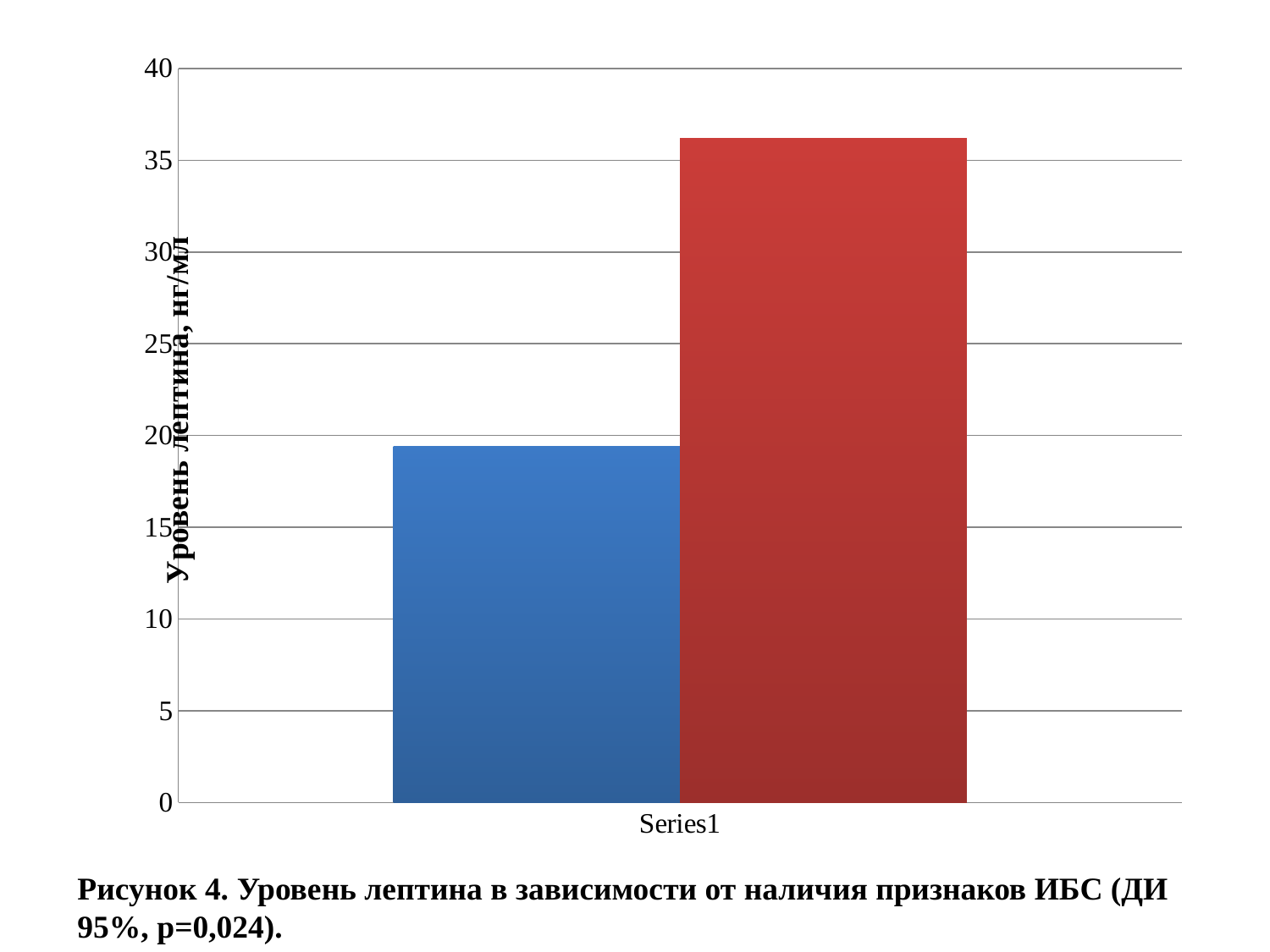
Which bar has the lowest value in the chart? the blue bar What is the label on the vertical axis of the chart? Уровень лептина, нг/мл Is the value of the blue bar greater or less than 20? less What kind of chart is shown on the slide? bar chart What is the category label shown under the bars on the horizontal axis? Series1 How many bars are plotted in the chart? 2 What is the maximum value shown on the vertical axis? 40 Is the value of the blue bar greater or less than 15? greater Is the value of the red bar greater or less than 40? less Which bar has the highest value in the chart? the red bar Which bar is taller, the blue bar or the red bar? the red bar